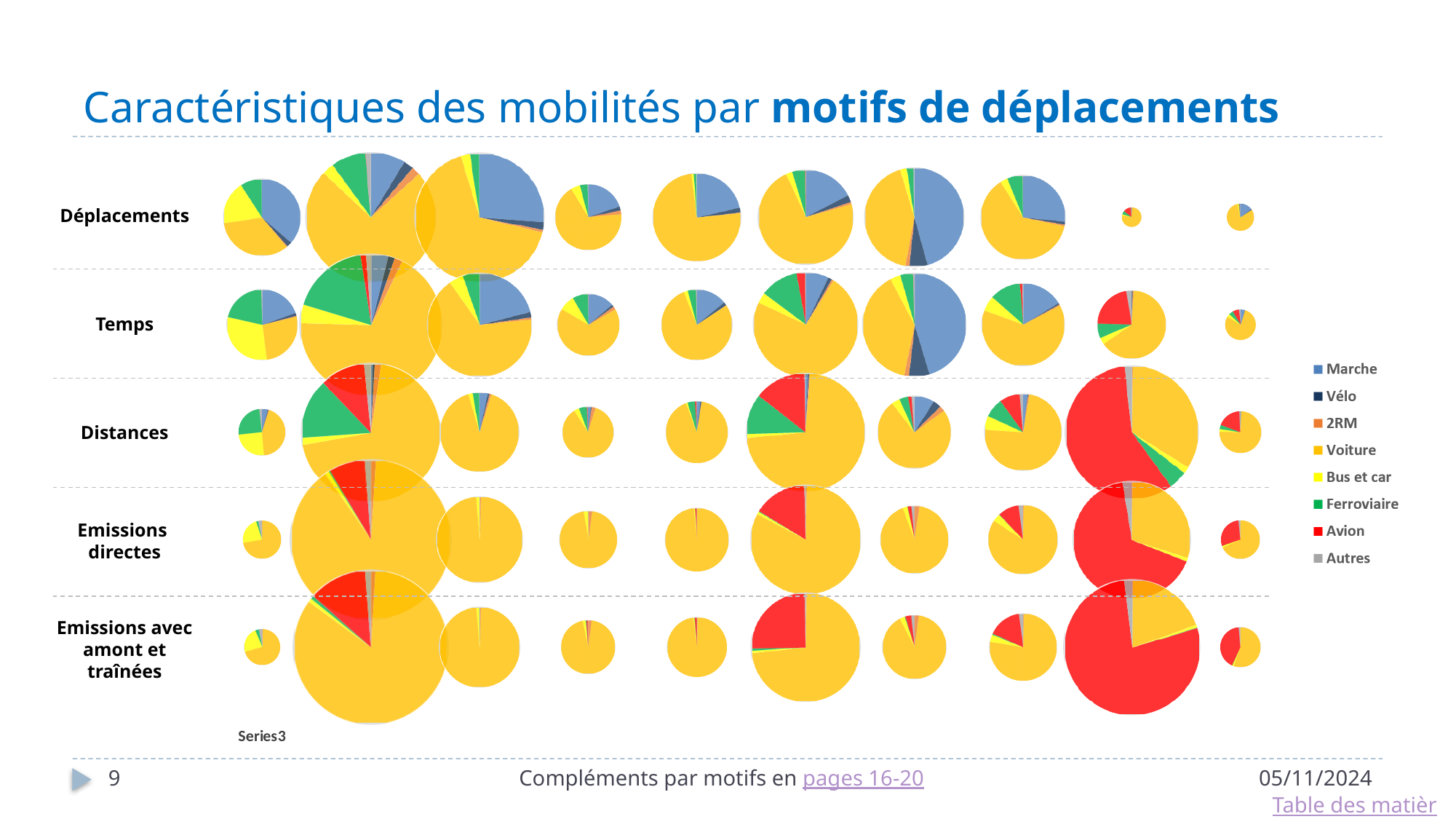
How many row categories are labelled on the left of the chart grid? 5 Which transport mode takes the largest share in most of the pie charts? Voiture What is the label of the bottom row of pie charts? Emissions avec amont et traînées In the large pie in the Emissions directes row, second from the right, which mode has the largest share? Avion In the Déplacements row, which mode has the largest share in the pies? Voiture What is the label of the top row of pie charts? Déplacements How many entries does the legend list? 8 Which legend entry is shown in red? Avion What kind of chart is used on this slide? pie charts Which legend entry is shown in green? Ferroviaire